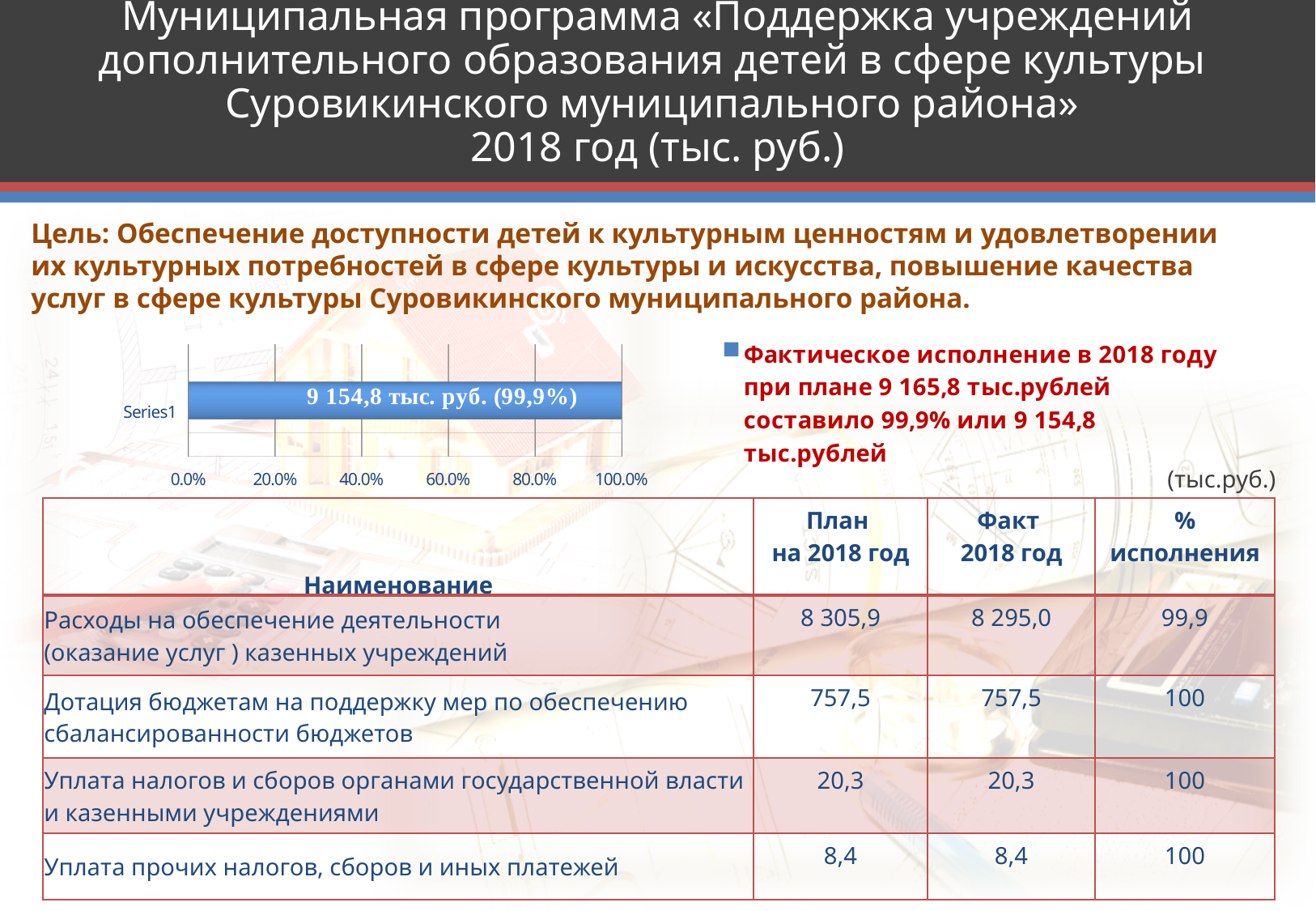
Is the value for Series1 greater or less than 80.0%? greater What percentage of execution is printed on the bar in the chart? 99,9% What kind of chart is shown on the slide? bar chart What is the label of the single category on the chart's vertical axis? Series1 What value is printed on the bar in the chart? 9 154,8 тыс. руб. (99,9%) What is the highest tick value shown on the chart's horizontal axis? 100.0% How many bars are plotted in the chart? 1 Is the value for Series1 greater or less than 60.0%? greater